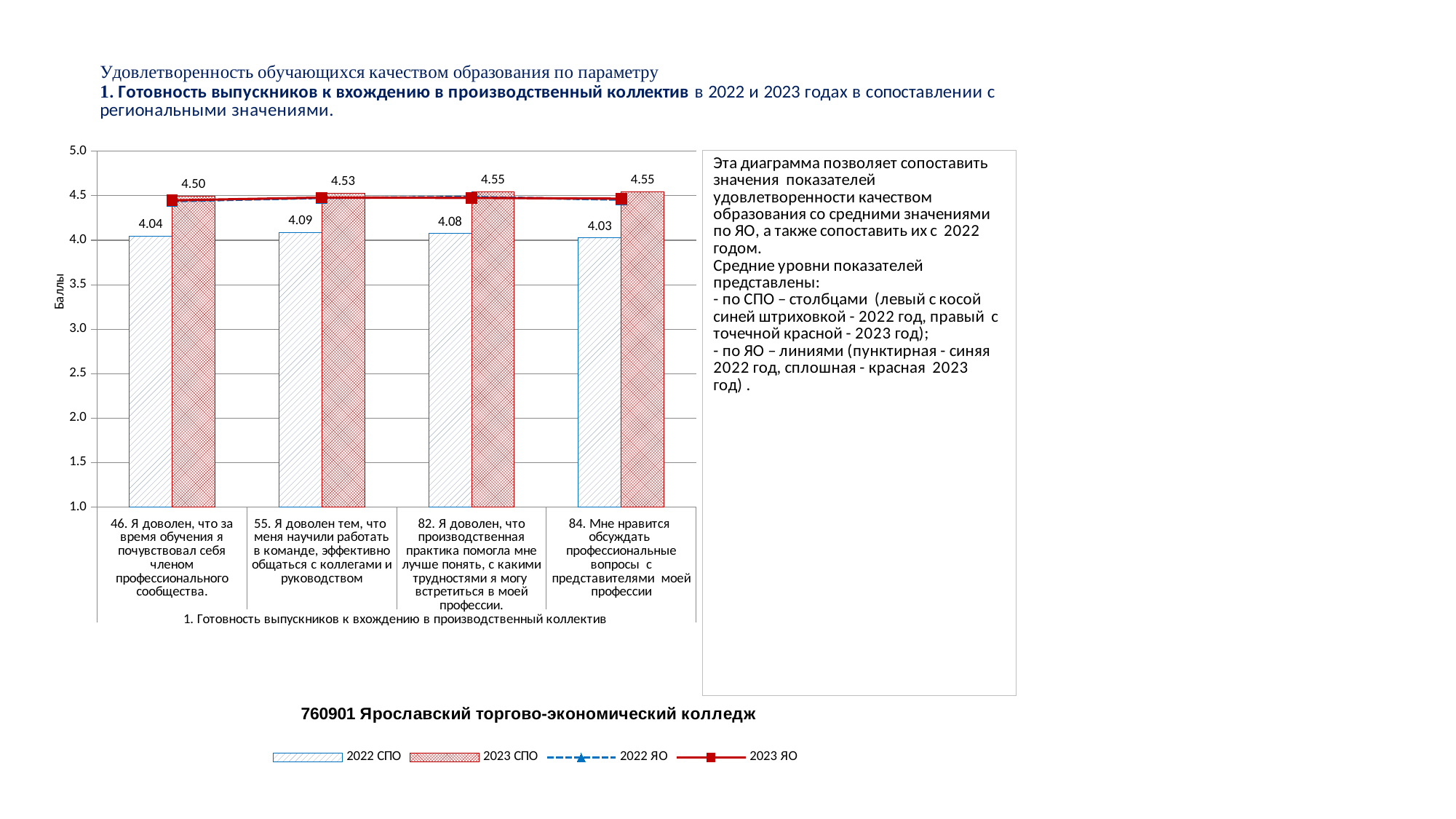
Which is larger: the 2022 СПО value for category 46 or for category 55? Category 55 What kind of chart is shown on the slide? Bar chart combined with line series What is the 2023 СПО value for category 55 (Я доволен тем, что меня научили работать в команде)? 4.53 How many categories are shown on the x axis of the chart? 4 Which category has the highest 2022 СПО value? 55. Я доволен тем, что меня научили работать в команде, эффективно общаться с коллегами и руководством Is the 2023 ЯО line value for category 46 greater or less than 4.0? greater How many series does the legend list? 4 What is the 2022 СПО value for category 84 (Мне нравится обсуждать профессиональные вопросы с представителями моей профессии)? 4.03 What is the 2022 СПО value for category 46 (Я доволен, что за время обучения я почувствовал себя членом профессионального сообщества)? 4.04 Which category has the lowest 2022 СПО value? 84. Мне нравится обсуждать профессиональные вопросы с представителями моей профессии What is the title of the y axis of the chart? Баллы What is the difference between the 2023 СПО and 2022 СПО values for category 46? 0.46